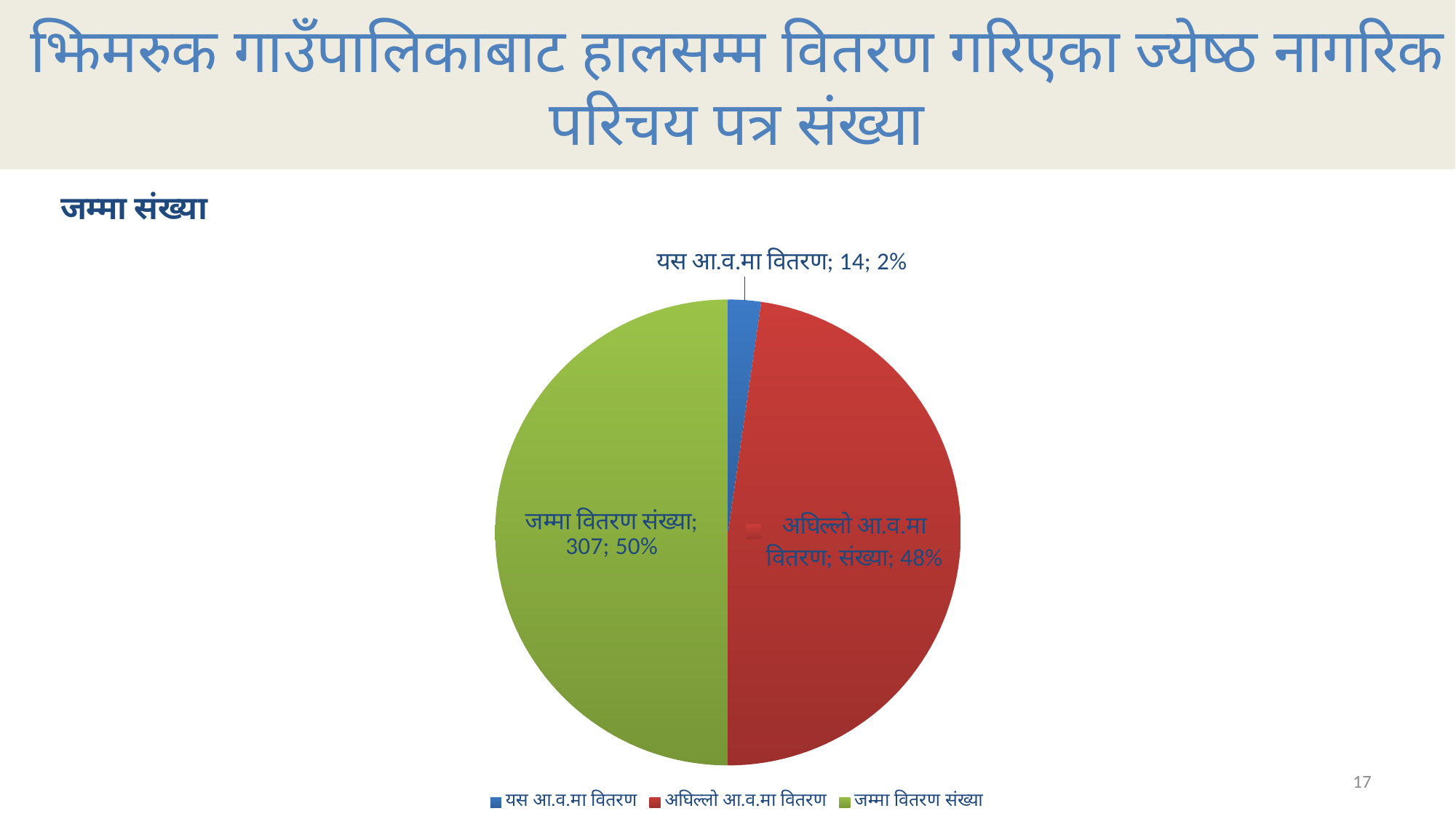
What is the value shown for यस आ.व.मा वितरण in the pie chart? 14 What share of the pie does यस आ.व.मा वितरण represent? 2% Which slice of the pie chart is the smallest? यस आ.व.मा वितरण Which slice of the pie chart is the largest? जम्मा वितरण संख्या How many slices does the pie chart have? 3 How many entries does the legend of the pie chart list? 3 What kind of chart is shown on the slide? pie chart What share of the pie does अघिल्लो आ.व.मा वितरण represent? 48% What share of the pie does जम्मा वितरण संख्या represent? 50% What is the difference between the values for जम्मा वितरण संख्या and यस आ.व.मा वितरण? 293 What is the value shown for जम्मा वितरण संख्या in the pie chart? 307 What is the title of the pie chart? जम्मा संख्या